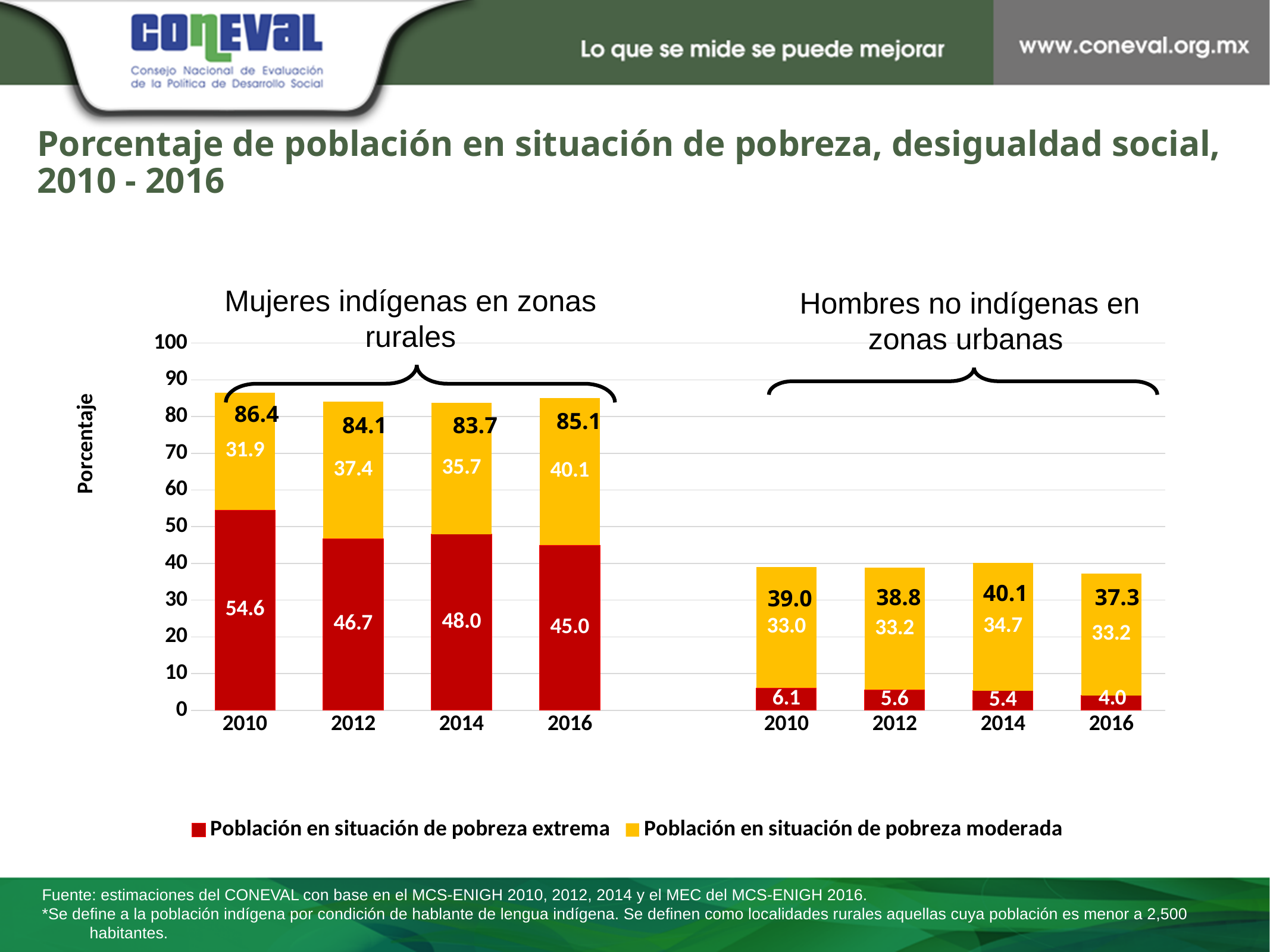
Does the 'Población en situación de pobreza extrema' value for Hombres no indígenas en zonas urbanas rise or fall from 2010 to 2016? fall How many series does the legend list? 2 Among the Hombres no indígenas en zonas urbanas bars, which year has the lowest value for 'Población en situación de pobreza extrema'? 2016 What is the difference between the 'Población en situación de pobreza extrema' values for Mujeres indígenas en zonas rurales in 2010 and 2016? 9.6 Among the Mujeres indígenas en zonas rurales bars, which year has the highest value for 'Población en situación de pobreza extrema'? 2010 What is the total percentage shown above the 2016 bar for Mujeres indígenas en zonas rurales? 85.1 What kind of chart is shown on the slide? stacked bar chart Which is larger: the 'Población en situación de pobreza moderada' value for Mujeres indígenas en zonas rurales in 2016 or for Hombres no indígenas en zonas urbanas in 2016? Mujeres indígenas en zonas rurales in 2016 What is the value of 'Población en situación de pobreza extrema' for Mujeres indígenas en zonas rurales in 2010? 54.6 What is the value of 'Población en situación de pobreza moderada' for Hombres no indígenas en zonas urbanas in 2014? 34.7 What is the total percentage shown above the 2012 bar for Hombres no indígenas en zonas urbanas? 38.8 How many bars are plotted in the chart in total? 8